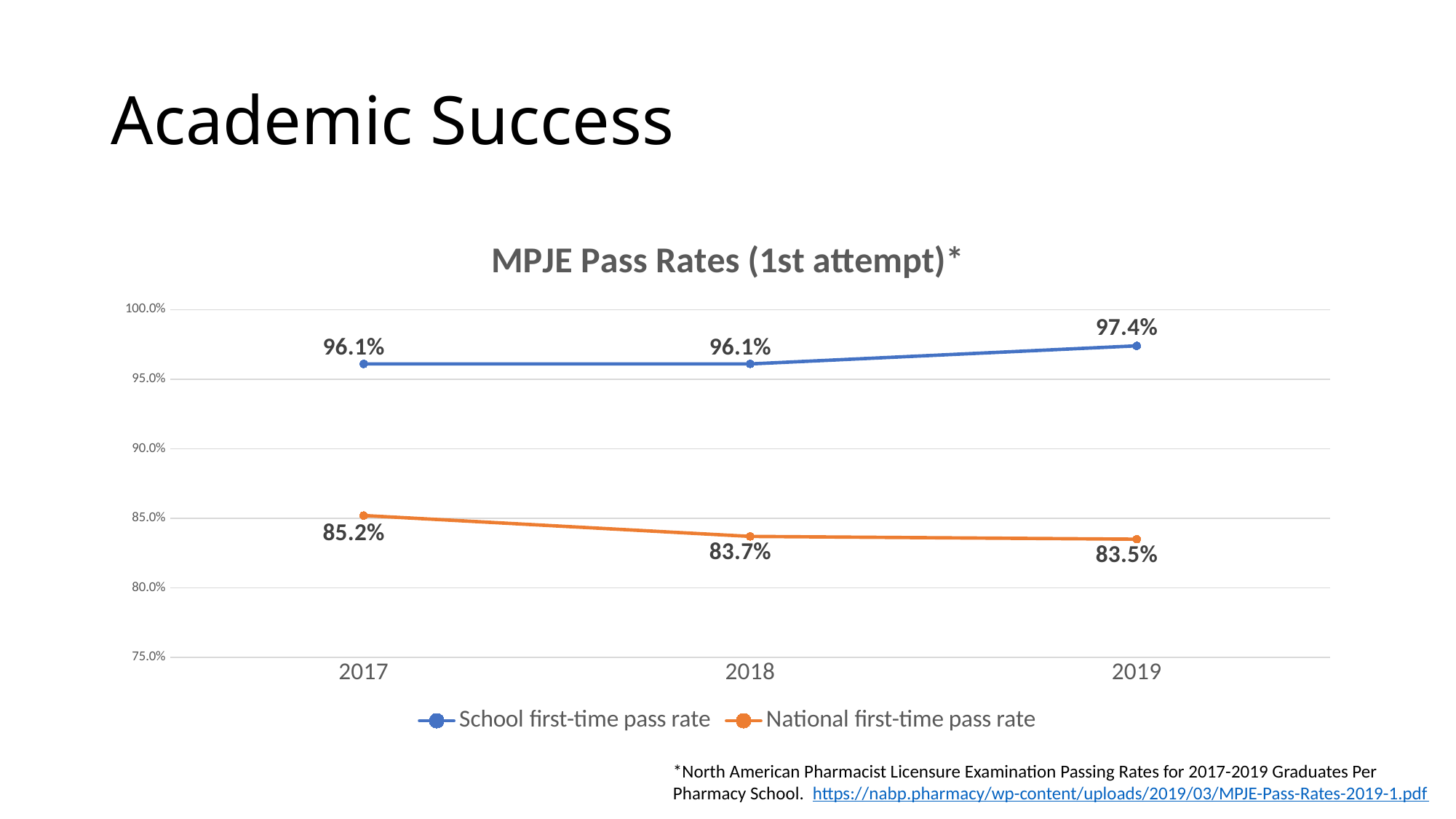
How many years are shown on the x axis? 3 In which year is the School first-time pass rate highest? 2019 What is the difference between the School and National first-time pass rates in 2019? 13.9% What is the National first-time pass rate in 2017? 85.2% Which is larger in 2017, the School first-time pass rate or the National first-time pass rate? School first-time pass rate Does the National first-time pass rate rise or fall from 2017 to 2019? fall What is the National first-time pass rate in 2018? 83.7% What kind of chart is shown? line chart How many series does the legend list? 2 In which year is the National first-time pass rate lowest? 2019 What is the School first-time pass rate in 2019? 97.4% Is the National first-time pass rate in 2018 greater or less than 85.0%? less